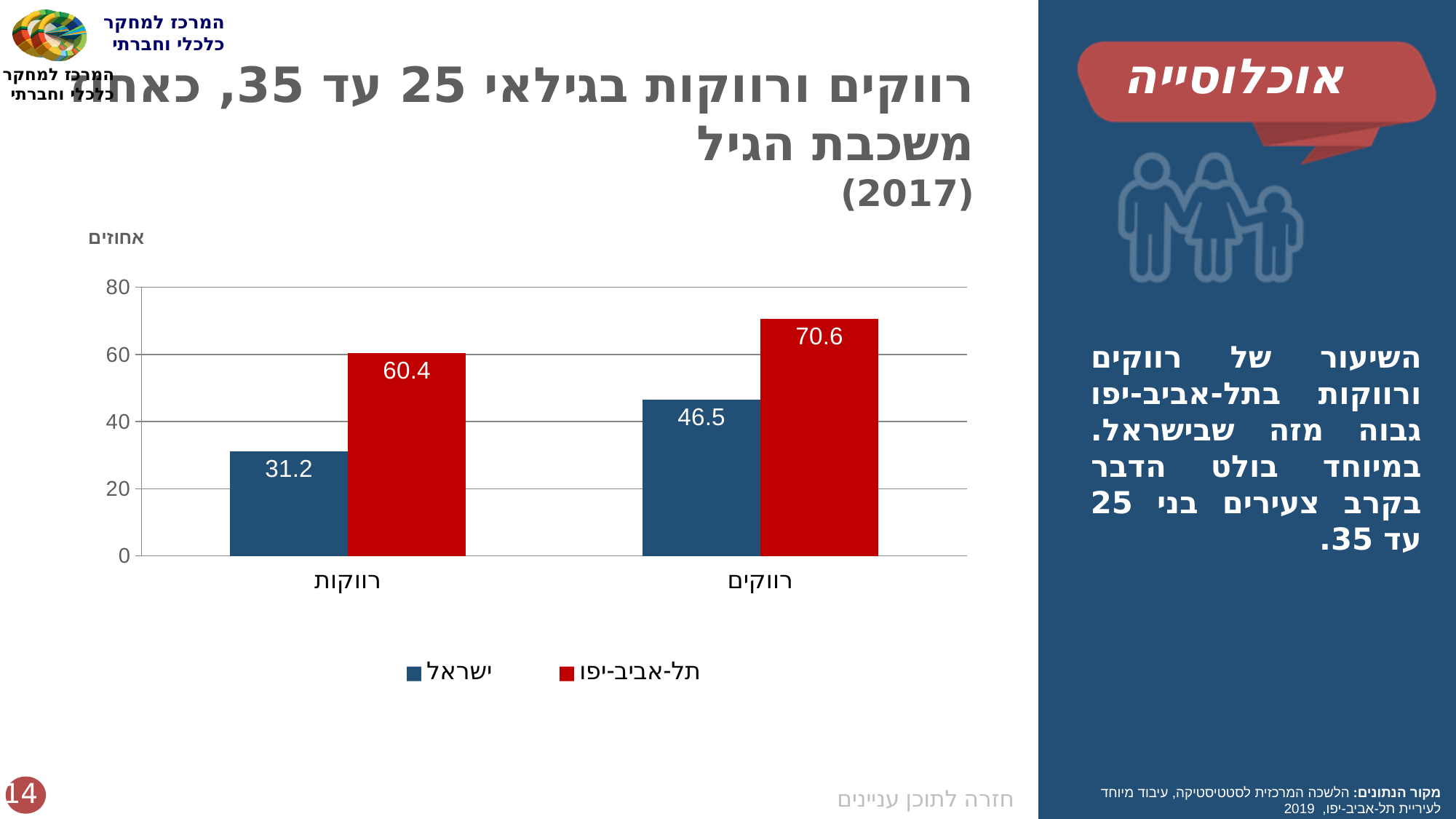
Which bar has the lowest value on the chart? ישראל, רווקות What is the difference between the תל-אביב-יפו and ישראל values in the רווקות category? 29.2 What kind of chart is shown on the slide? Bar chart What is the value for תל-אביב-יפו in the רווקות category? 60.4 Which bar has the highest value on the chart? תל-אביב-יפו, רווקים How many series does the legend list? 2 What is the value for ישראל in the רווקות category? 31.2 What is the difference between the תל-אביב-יפו and ישראל values in the רווקים category? 24.1 Which is larger: the ישראל value for רווקים or the תל-אביב-יפו value for רווקות? תל-אביב-יפו value for רווקות How many categories are shown on the x axis? 2 What is the value for תל-אביב-יפו in the רווקים category? 70.6 What is the value for ישראל in the רווקים category? 46.5